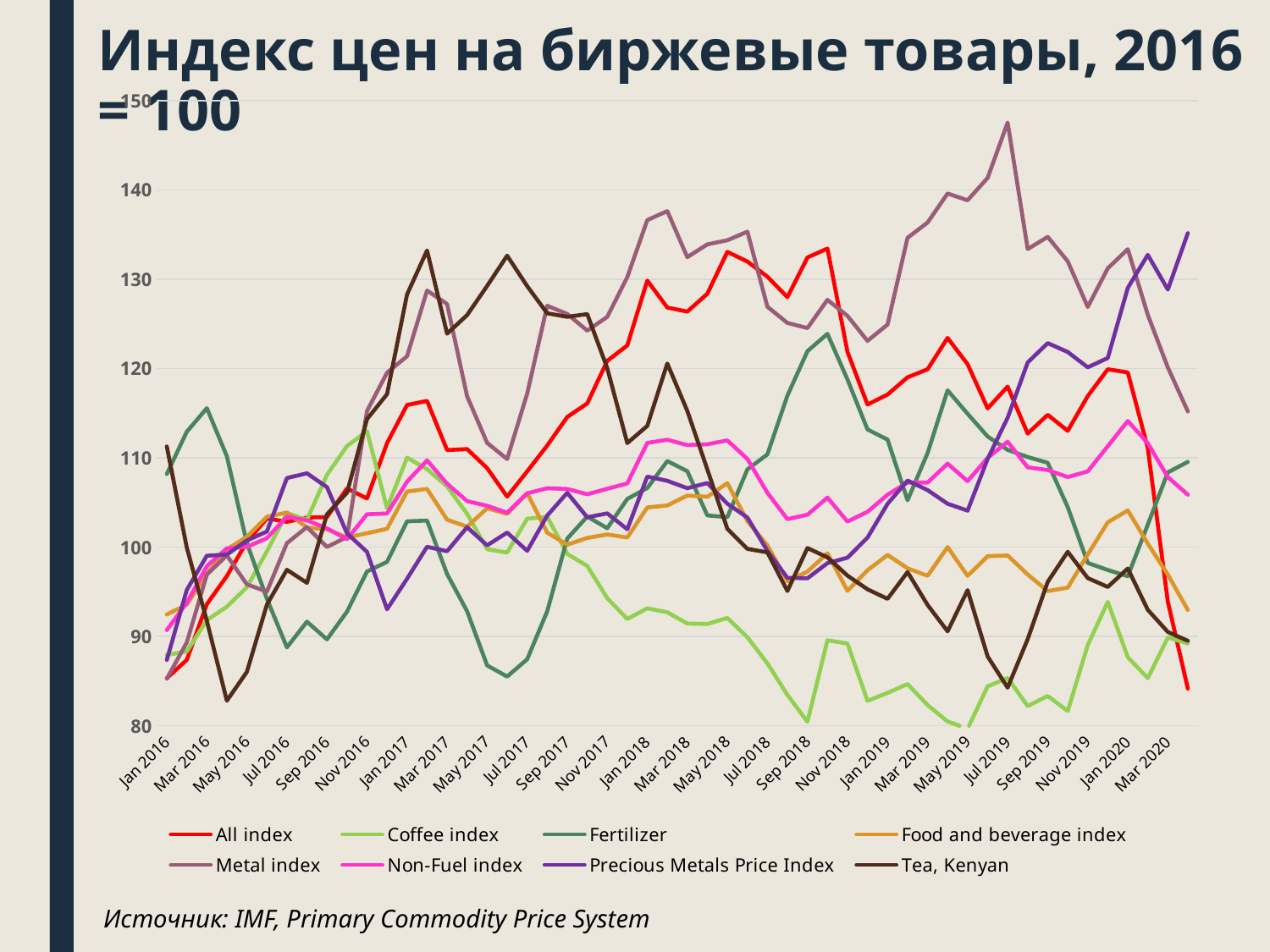
Is the value of Tea, Kenyan in Mar 2017 greater or less than 120? greater How many series does the legend list? 8 What kind of chart is shown on the slide? Line chart Is the value of the All index in Mar 2020 greater or less than 90? greater In Mar 2020, which is higher: the Precious Metals Price Index or the All index? Precious Metals Price Index Which series falls to the lowest value anywhere on the chart? Coffee index Does the Coffee index rise or fall between Jan 2017 and Sep 2018? Fall Is the value of the Metal index in Jul 2019 greater or less than 140? greater Which series reaches the highest value anywhere on the chart? Metal index What source is cited below the chart? IMF, Primary Commodity Price System